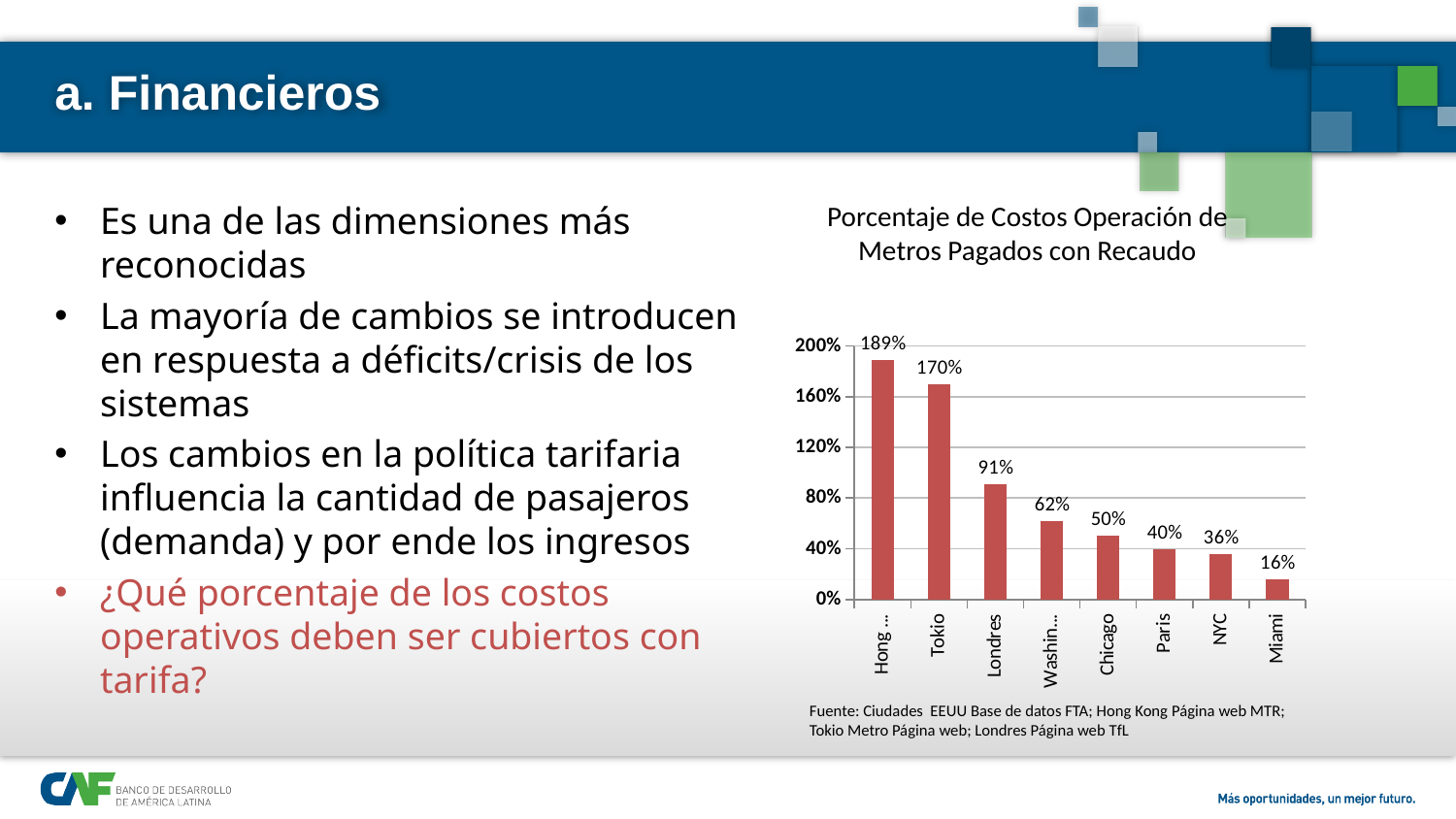
Is the value for Londres greater or less than 80%? greater What is the value of the tallest bar? 189% Which is larger, the value for Paris or the value for NYC? Paris What is the difference between the values for Tokio and Londres? 79% What is the value for Tokio? 170% How many cities are shown in the chart? 8 Do the values rise or fall from left to right along the x axis? fall Which city has the lowest value? Miami What kind of chart is shown? bar chart What is the value for Chicago? 50% What is the value for Miami? 16% What is the value for Londres? 91%